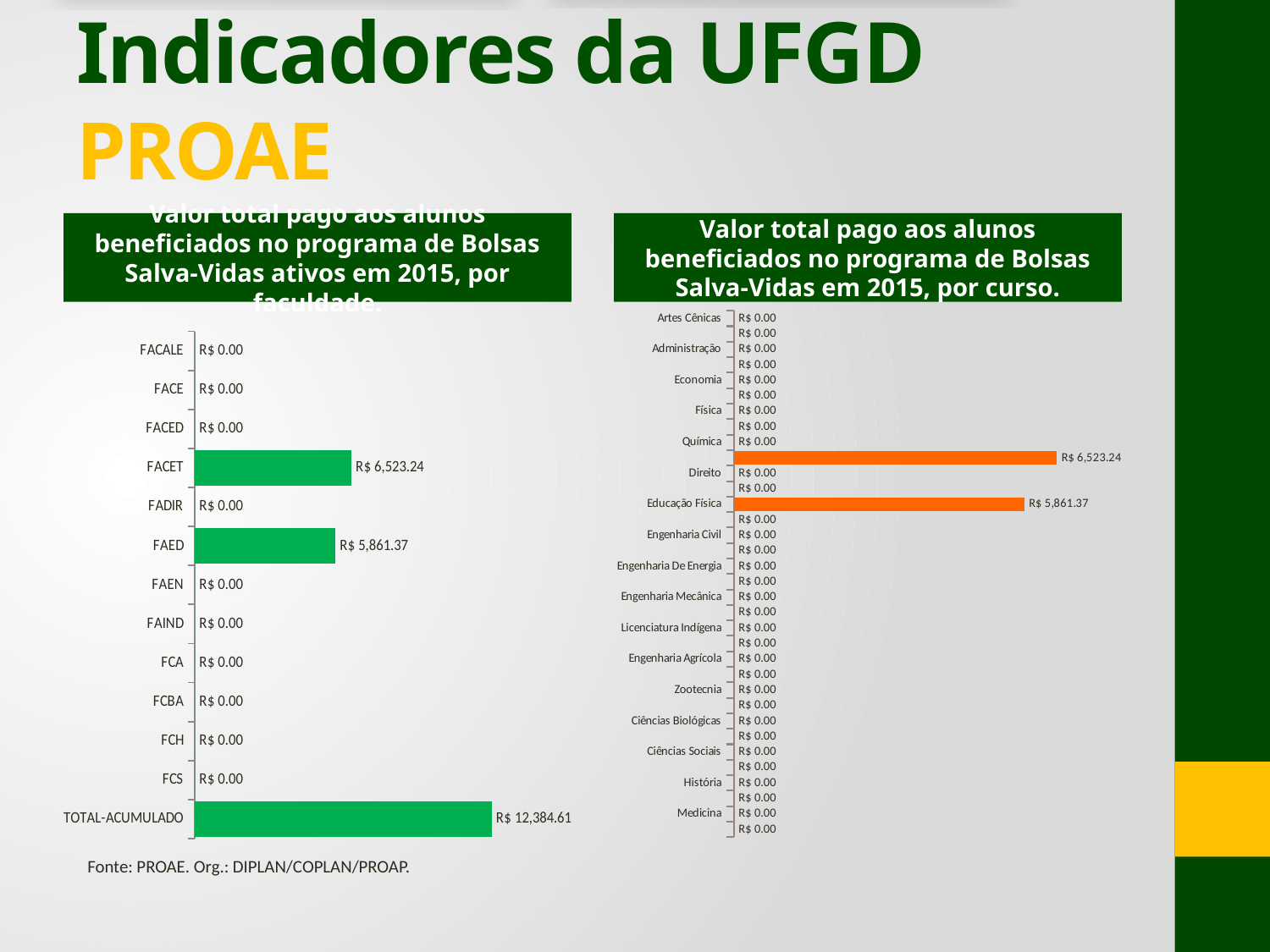
In the left chart (por faculdade), what is the value for FACALE? R$ 0.00 In the left chart (por faculdade), what is the value for FAED? R$ 5,861.37 In the left chart (por faculdade), what is the value for FACET? R$ 6,523.24 In the right chart (por curso), what is the value for Educação Física? R$ 5,861.37 In the left chart (por faculdade), what is the difference between the values for FACET and FAED? R$ 661.87 In the right chart (por curso), what is the highest value shown? R$ 6,523.24 In the right chart (por curso), what is the value for Medicina? R$ 0.00 In the left chart (por faculdade), which individual faculty (excluding TOTAL-ACUMULADO) has the highest value? FACET What kind of chart is the left chart (por faculdade)? Bar chart In the left chart (por faculdade), how many categories are shown on the vertical axis? 13 In the left chart (por faculdade), which is larger, the value for FACET or the value for FAED? FACET In the left chart (por faculdade), what is the value for TOTAL-ACUMULADO? R$ 12,384.61